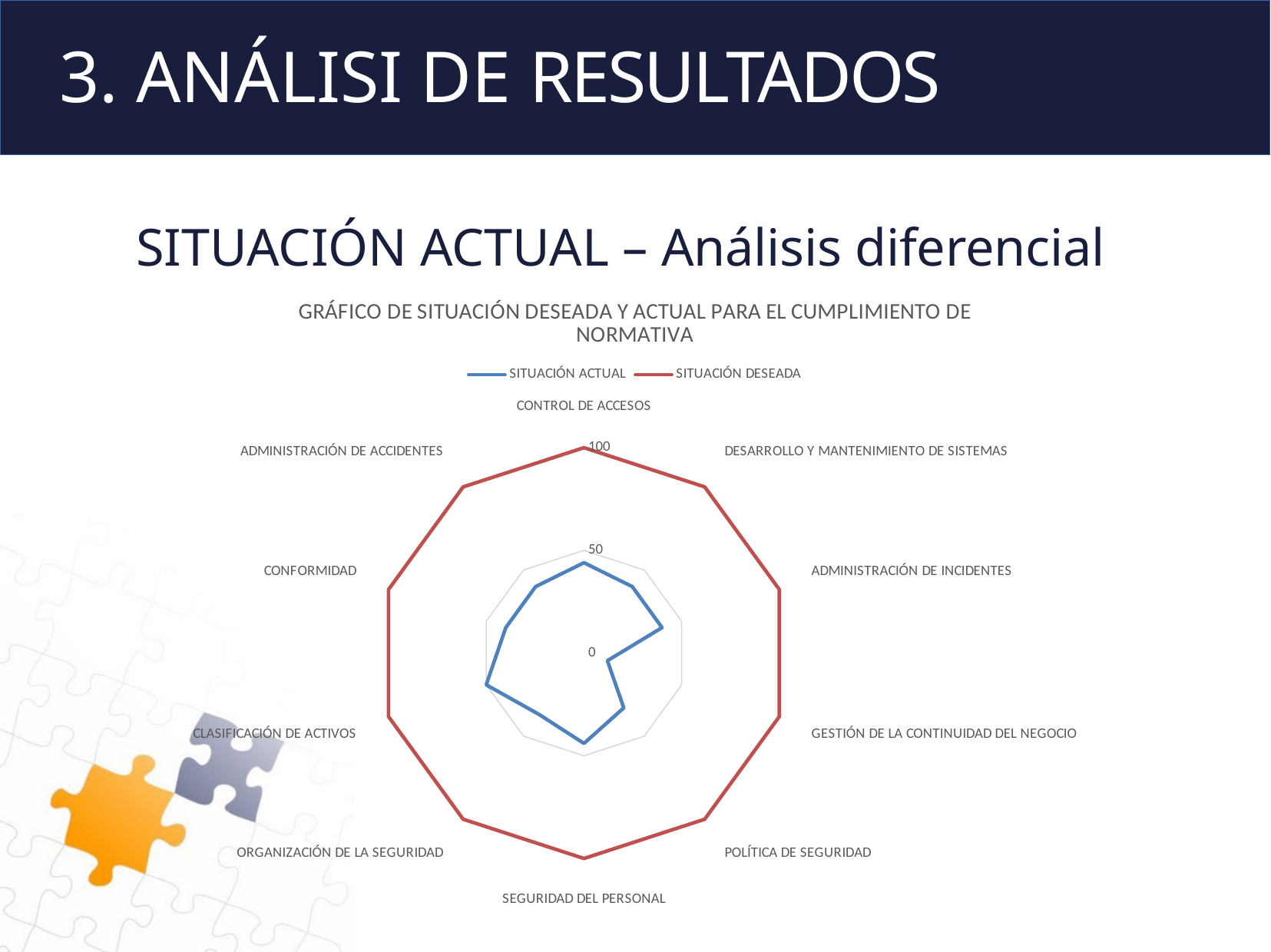
Is the SITUACIÓN ACTUAL value for GESTIÓN DE LA CONTINUIDAD DEL NEGOCIO greater or less than 50? less Is the SITUACIÓN ACTUAL value for ADMINISTRACIÓN DE INCIDENTES greater or less than 50? less Which category has the lowest SITUACIÓN ACTUAL value? GESTIÓN DE LA CONTINUIDAD DEL NEGOCIO What kind of chart is shown on the slide? Radar chart What is the value of SITUACIÓN DESEADA for POLÍTICA DE SEGURIDAD? 100 How many series does the legend list? 2 What is the title of the chart? GRÁFICO DE SITUACIÓN DESEADA Y ACTUAL PARA EL CUMPLIMIENTO DE NORMATIVA Is the SITUACIÓN ACTUAL value for POLÍTICA DE SEGURIDAD greater or less than 50? less For SEGURIDAD DEL PERSONAL, which series has the larger value, SITUACIÓN ACTUAL or SITUACIÓN DESEADA? SITUACIÓN DESEADA Which colour represents the SITUACIÓN ACTUAL series? Blue How many categories (axes) does the radar chart have? 10 What is the value of SITUACIÓN DESEADA for CONTROL DE ACCESOS? 100